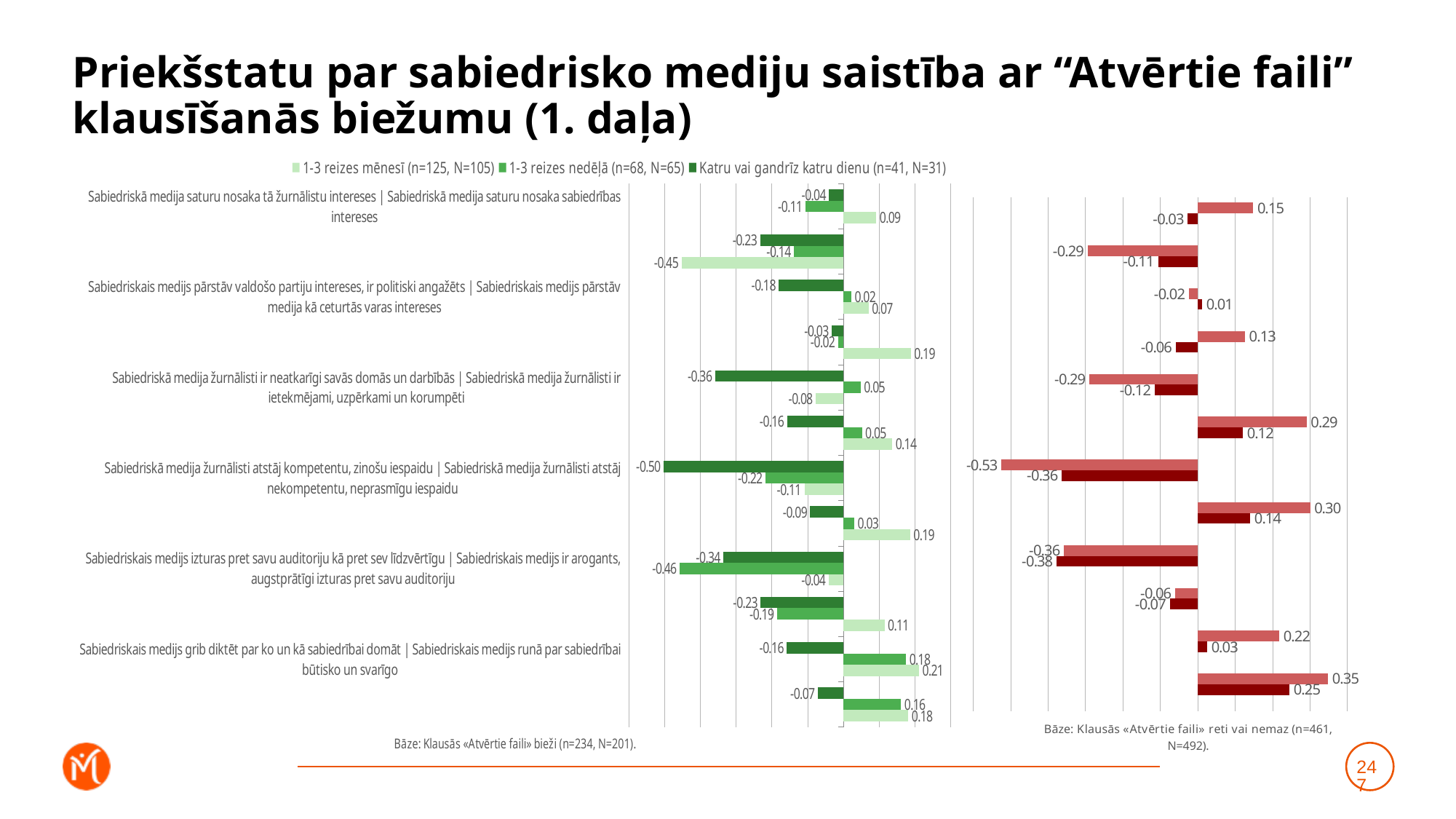
In the left chart, which series does the value -0.45 belong to? 1-3 reizes mēnesī (n=125, N=105) What is the lowest value shown in the right (red) chart? -0.53 In the left chart, which series does the value -0.50 belong to? Katru vai gandrīz katru dienu (n=41, N=31) In the right chart, the bottom pair of bars shows 0.35 and 0.25; what is the difference between them? 0.10 What base note is printed under the left chart? Bāze: Klausās «Atvērtie faili» bieži (n=234, N=201). What is the first legend entry of the left chart? 1-3 reizes mēnesī (n=125, N=105) What is the highest value shown in the left (green) chart? 0.21 How many series does the legend above the left chart list? 3 Which chart contains the larger maximum value: the left (green) chart with 0.21 or the right (red) chart with 0.35? the right (red) chart What is the highest value shown in the right (red) chart? 0.35 What is the lowest value shown in the left (green) chart? -0.50 What kind of chart is the left chart on the slide? bar chart